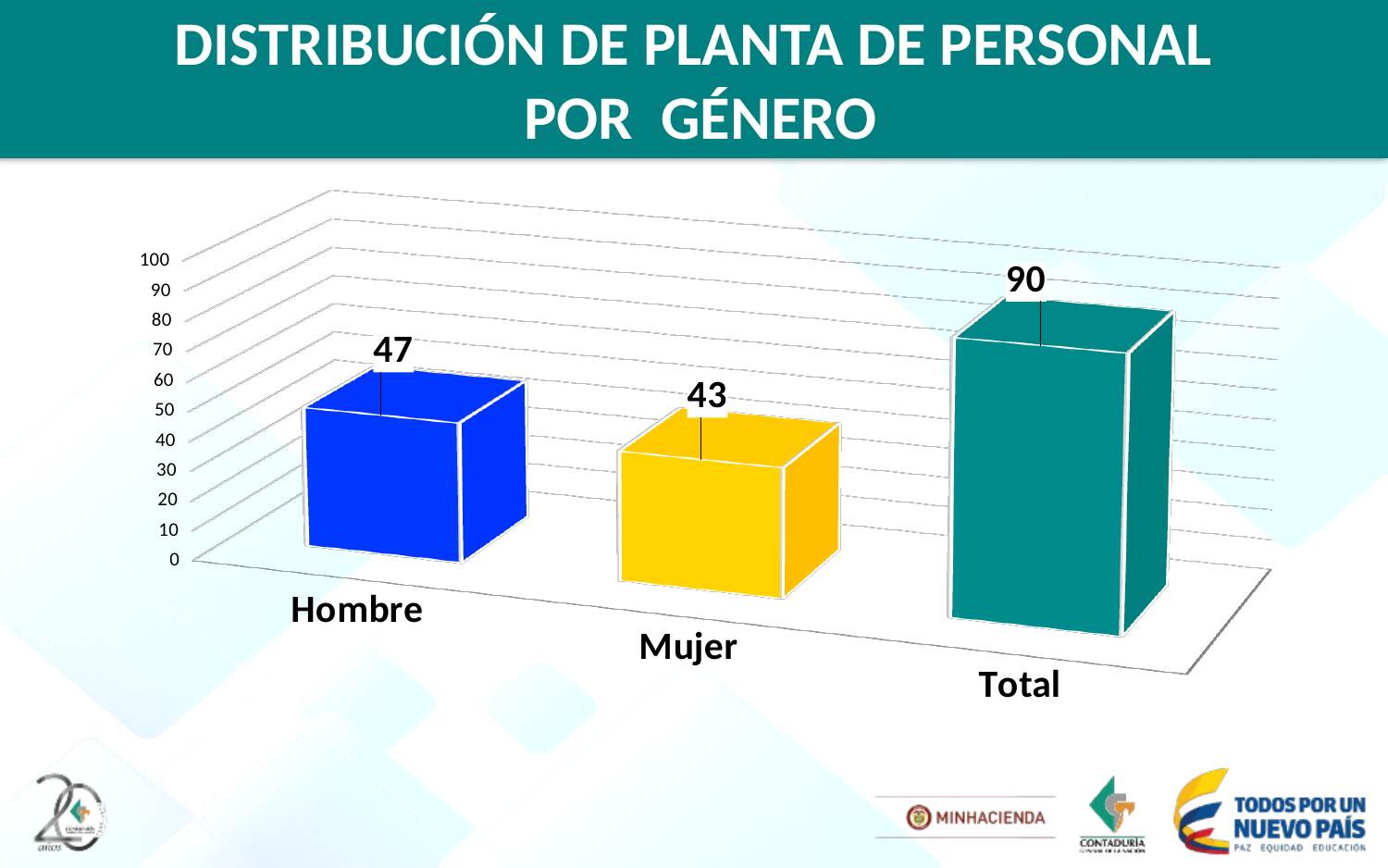
What is the value for Total? 90 What is the value for Hombre? 47 Which category has the lowest value? Mujer What is the value for Mujer? 43 Which category has the highest value? Total What colour is the bar for Mujer? yellow What is the title of the slide? DISTRIBUCIÓN DE PLANTA DE PERSONAL POR GÉNERO Is the value for Total greater or less than 80? greater What kind of chart is shown on the slide? bar chart What is the difference between the values for Hombre and Mujer? 4 How many categories are shown on the x axis? 3 Which is larger, the value for Hombre or the value for Mujer? Hombre